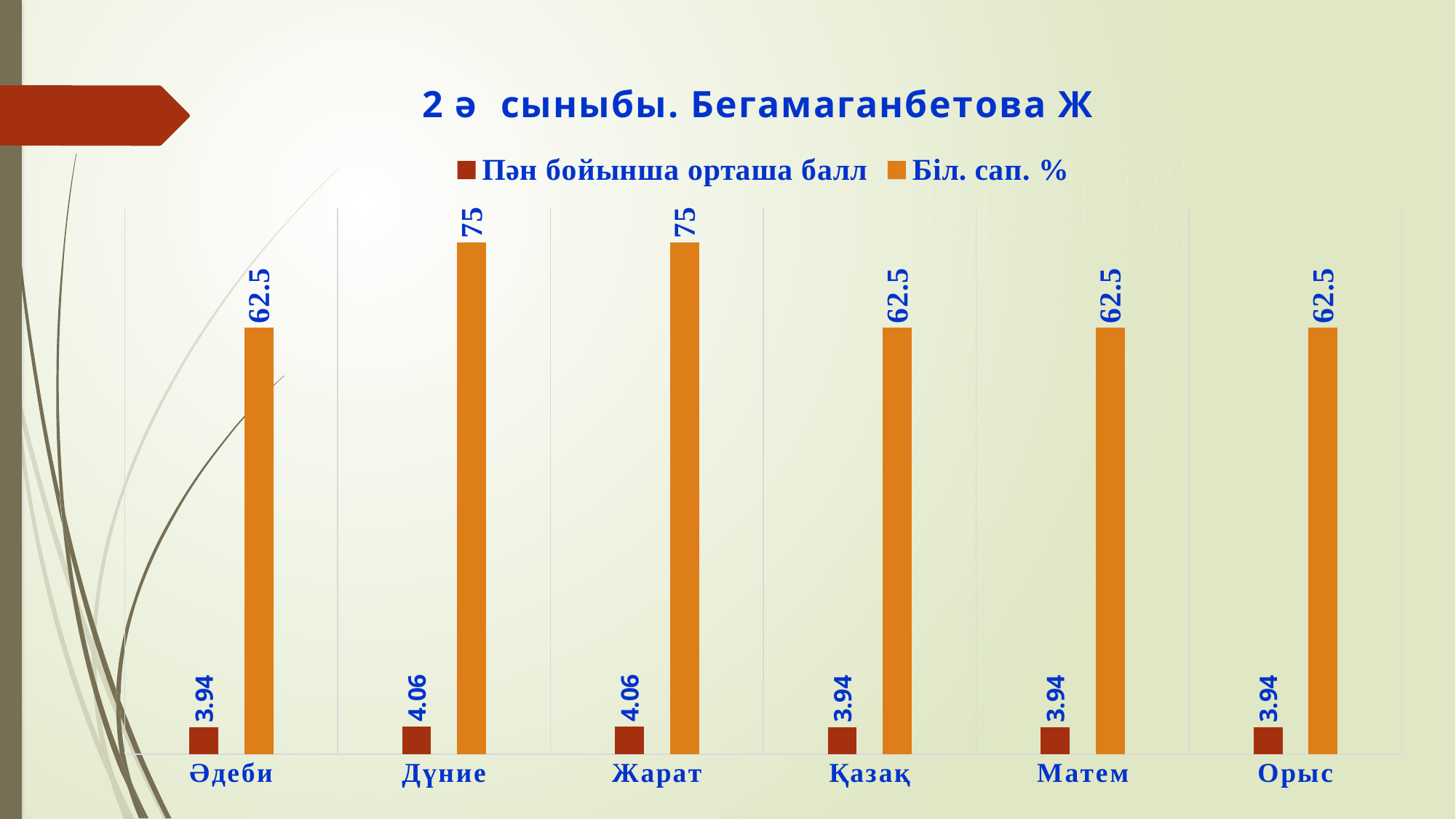
What is the title of the chart? 2 ә сыныбы. Бегамаганбетова Ж Which is larger: the "Біл. сап. %" value for Жарат or for Матем? Жарат What is the value of "Пән бойынша орташа балл" for Жарат? 4.06 What is the difference between the "Біл. сап. %" values for Дүние and Әдеби? 12.5 What kind of chart is shown on the slide? Bar chart What is the value of "Пән бойынша орташа балл" for Қазақ? 3.94 What is the difference between the "Пән бойынша орташа балл" values for Дүние and Матем? 0.12 What is the value of "Біл. сап. %" for Дүние? 75 How many series does the legend list? 2 How many categories are shown on the x axis? 6 Which categories have the highest value of "Біл. сап. %"? Дүние and Жарат What is the value of "Біл. сап. %" for Орыс? 62.5